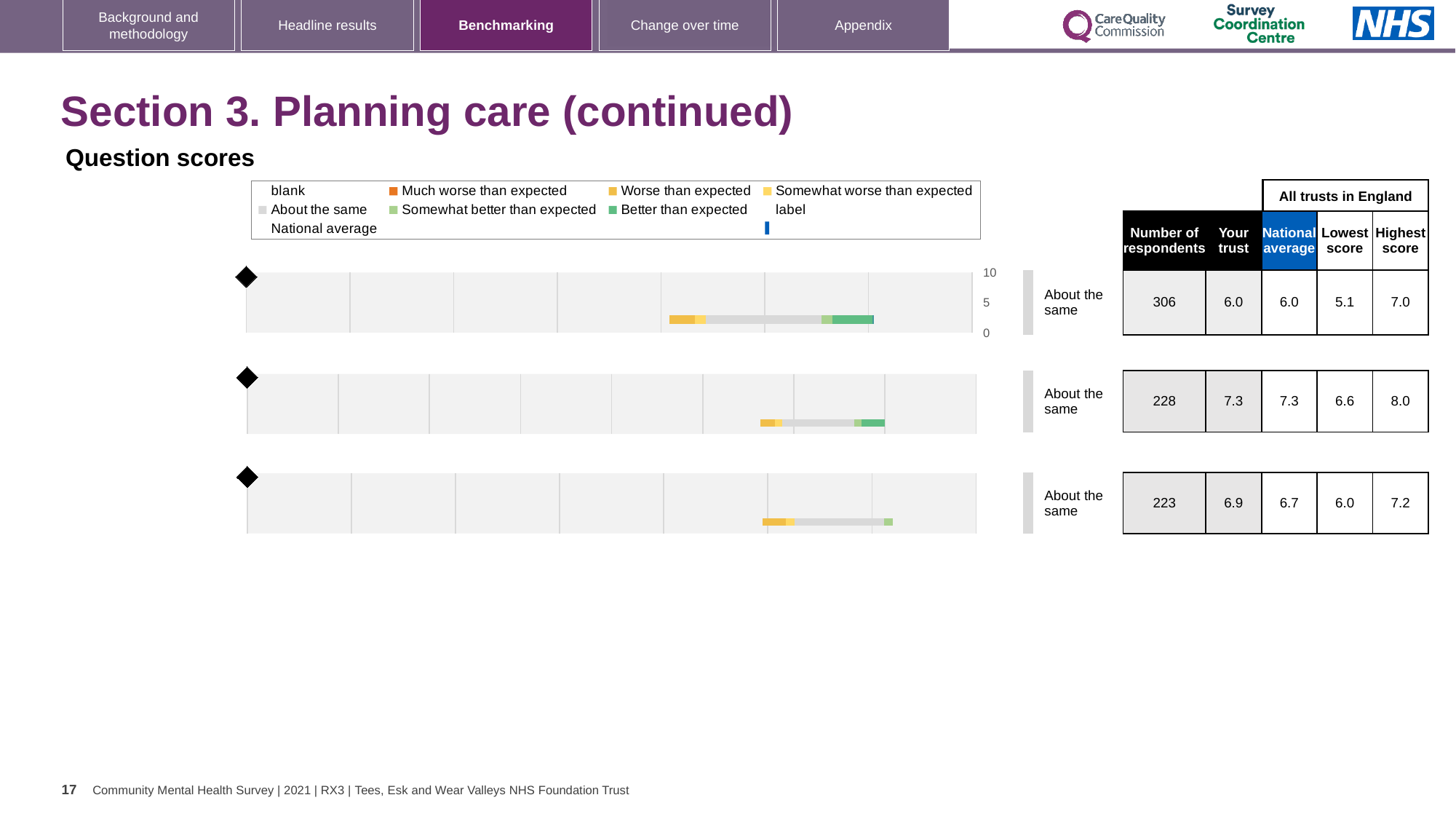
What kind of chart is used for the benchmarking rows on the slide? bar chart For the bottom chart row, what is the national average score? 6.7 For the bottom chart row, what is the difference between the highest score and the lowest score? 1.2 How many benchmarking charts are shown on the slide? 3 Which chart row has the highest 'Your trust' score? the middle row (7.3) For the bottom chart row, which is larger: the 'Your trust' score or the national average? Your trust For the middle chart row, what is the lowest score among all trusts in England? 6.6 For the middle chart row, what is the 'Your trust' score? 7.3 What is the maximum value shown on the score axis of the top chart? 10 What benchmark category is shown next to each of the three chart rows? About the same For the top chart row, what is the number of respondents shown in the table? 306 For the top chart row, what is the highest score among all trusts in England? 7.0